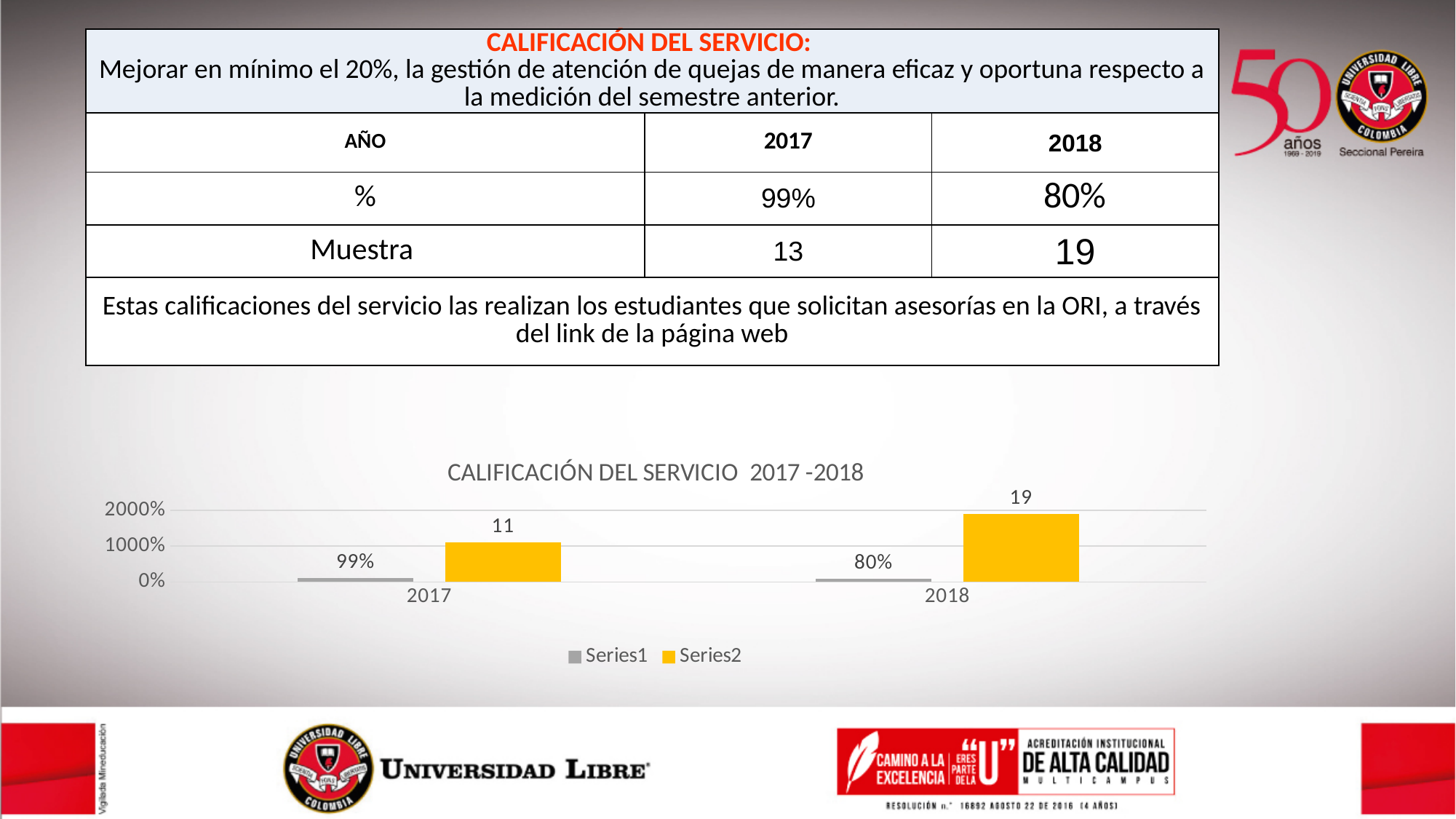
Which year has the higher Series2 value? 2018 What is the data label for Series1 in 2018? 80% What is the title of the chart? CALIFICACIÓN DEL SERVICIO 2017 -2018 How many years (categories) are shown on the x axis? 2 What is the data label for Series1 in 2017? 99% What is the data label for Series2 in 2018? 19 What is the data label for Series2 in 2017? 11 Is the Series1 value for 2017 larger or smaller than the Series1 value for 2018? larger How many series does the legend list? 2 What is the difference between the Series2 values for 2018 and 2017? 8 What kind of chart is shown on the slide? bar chart Which year has the lower Series1 value? 2018